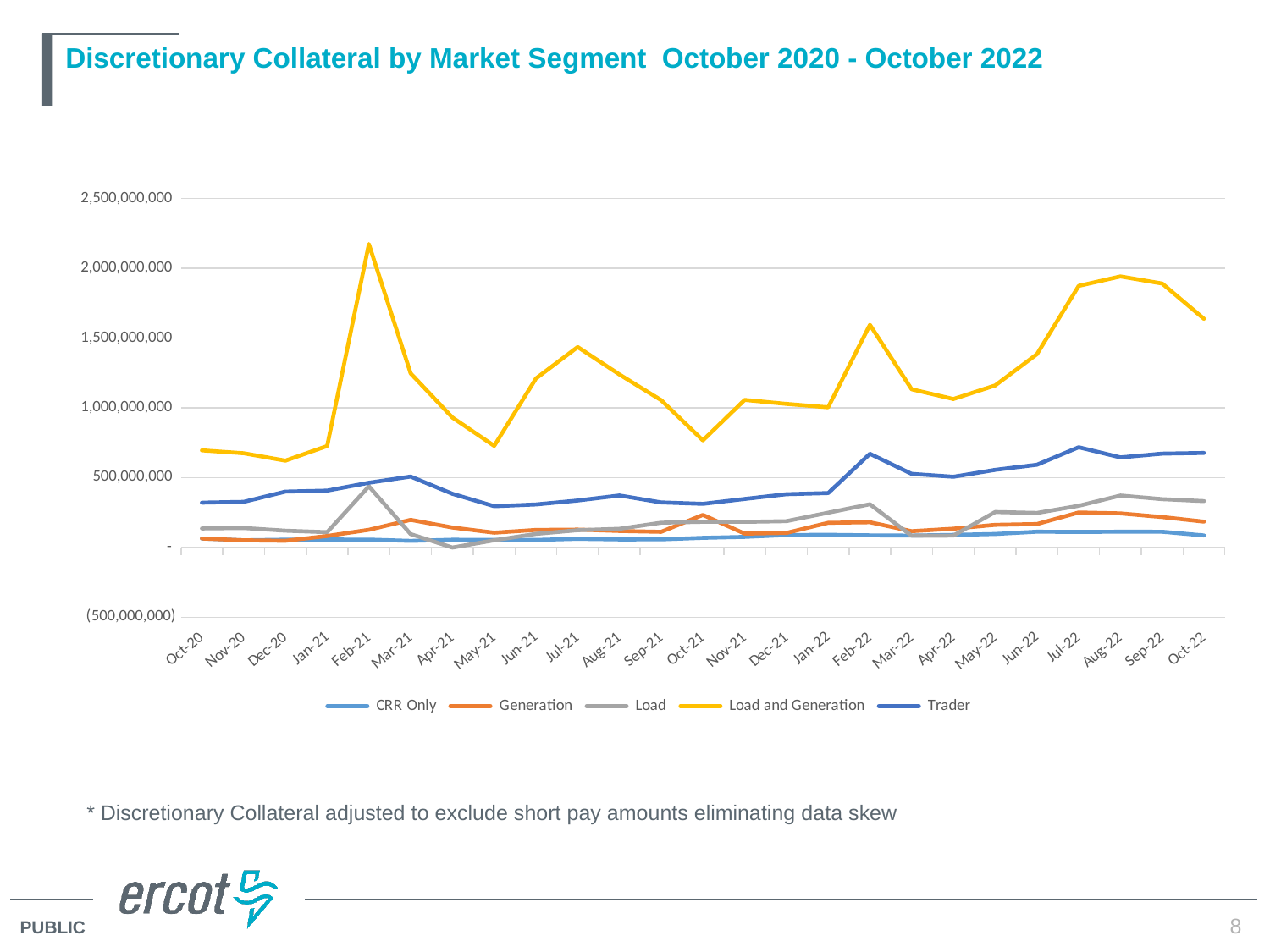
What kind of chart is shown on the slide? line chart Is the value for Trader in Oct-22 greater or less than 500,000,000? greater How many series does the legend list? 5 In which month does the Load and Generation series reach its highest value? Feb-21 Which is larger in Oct-22, the Trader value or the Generation value? Trader In which month does the Load series reach its lowest value? Apr-21 Is the value for Load and Generation in Oct-21 greater or less than 1,000,000,000? less Which market segment has the highest discretionary collateral across the period? Load and Generation Does the Load and Generation series rise or fall from Apr-22 to Aug-22? rise What colour is the Load and Generation line in the legend? yellow How many months are plotted along the x axis? 25 Is the value for Load and Generation in Feb-21 greater or less than 2,000,000,000? greater